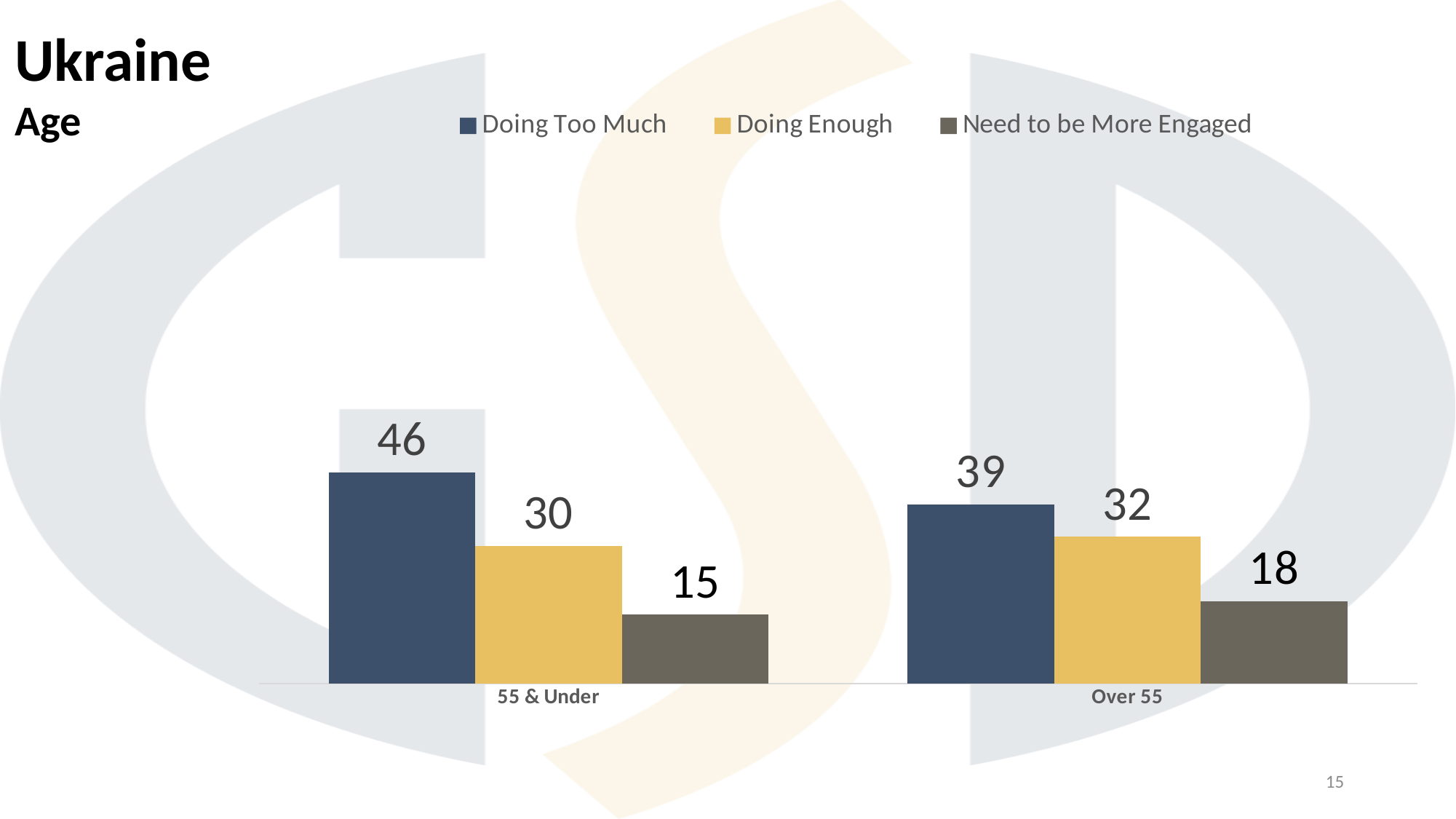
How many series does the legend list? 3 Which series has the lowest value in the Over 55 group? Need to be More Engaged Which is larger: Doing Enough for 55 & Under or Doing Enough for Over 55? Over 55 What is the value for Need to be More Engaged in the 55 & Under group? 15 Which colour represents the Doing Enough series? Yellow What is the value for Doing Too Much in the Over 55 group? 39 What is the value for Doing Enough in the Over 55 group? 32 What kind of chart is shown on the slide? Bar chart How many age categories are shown on the x axis? 2 Which series has the highest value in the 55 & Under group? Doing Too Much What is the value for Doing Too Much in the 55 & Under group? 46 What is the difference between Doing Too Much for 55 & Under and Doing Too Much for Over 55? 7